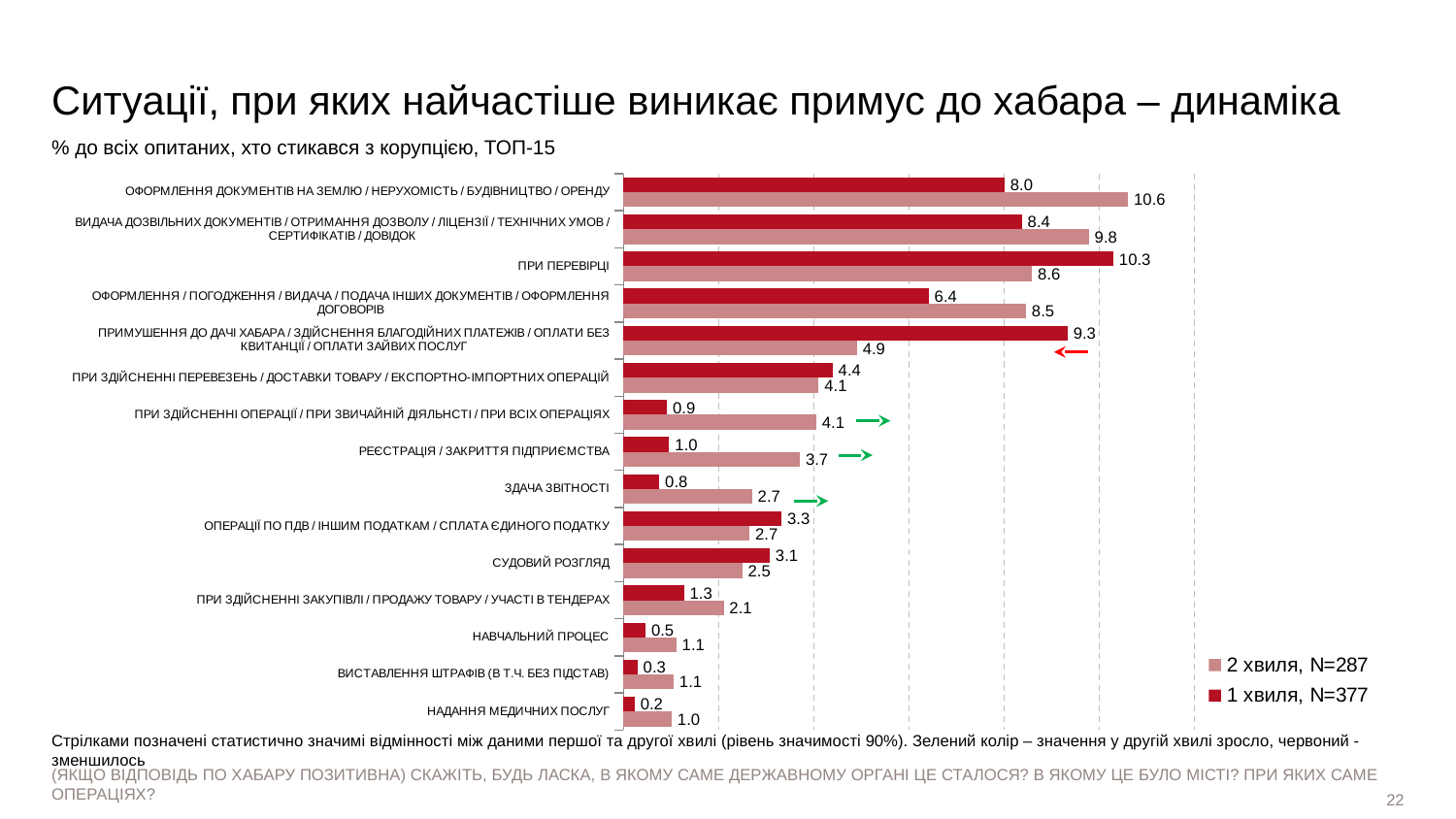
How many series does the legend list? 2 What is the sample size (N) for the "2 хвиля" series according to the legend? 287 How many categories are shown in the chart? 15 What is the value for "ПРИ ПЕРЕВІРЦІ" in the "1 хвиля, N=377" series? 10.3 Which category has the highest value in the "2 хвиля, N=287" series? ОФОРМЛЕННЯ ДОКУМЕНТІВ НА ЗЕМЛЮ / НЕРУХОМІСТЬ / БУДІВНИЦТВО / ОРЕНДУ What is the difference between the "2 хвиля, N=287" and "1 хвиля, N=377" values for "РЕЄСТРАЦІЯ / ЗАКРИТТЯ ПІДПРИЄМСТВА"? 2.7 For "ПРИМУШЕННЯ ДО ДАЧІ ХАБАРА / ЗДІЙСНЕННЯ БЛАГОДІЙНИХ ПЛАТЕЖІВ / ОПЛАТИ БЕЗ КВИТАНЦІЇ / ОПЛАТИ ЗАЙВИХ ПОСЛУГ", which series has the larger value? 1 хвиля, N=377 What is the value for "НАДАННЯ МЕДИЧНИХ ПОСЛУГ" in the "1 хвиля, N=377" series? 0.2 Which category has the lowest value in the "1 хвиля, N=377" series? НАДАННЯ МЕДИЧНИХ ПОСЛУГ Is the "2 хвиля, N=287" value for "СУДОВИЙ РОЗГЛЯД" greater or less than 3? less What is the value for "ЗДАЧА ЗВІТНОСТІ" in the "2 хвиля, N=287" series? 2.7 What type of chart is shown on the slide? Bar chart